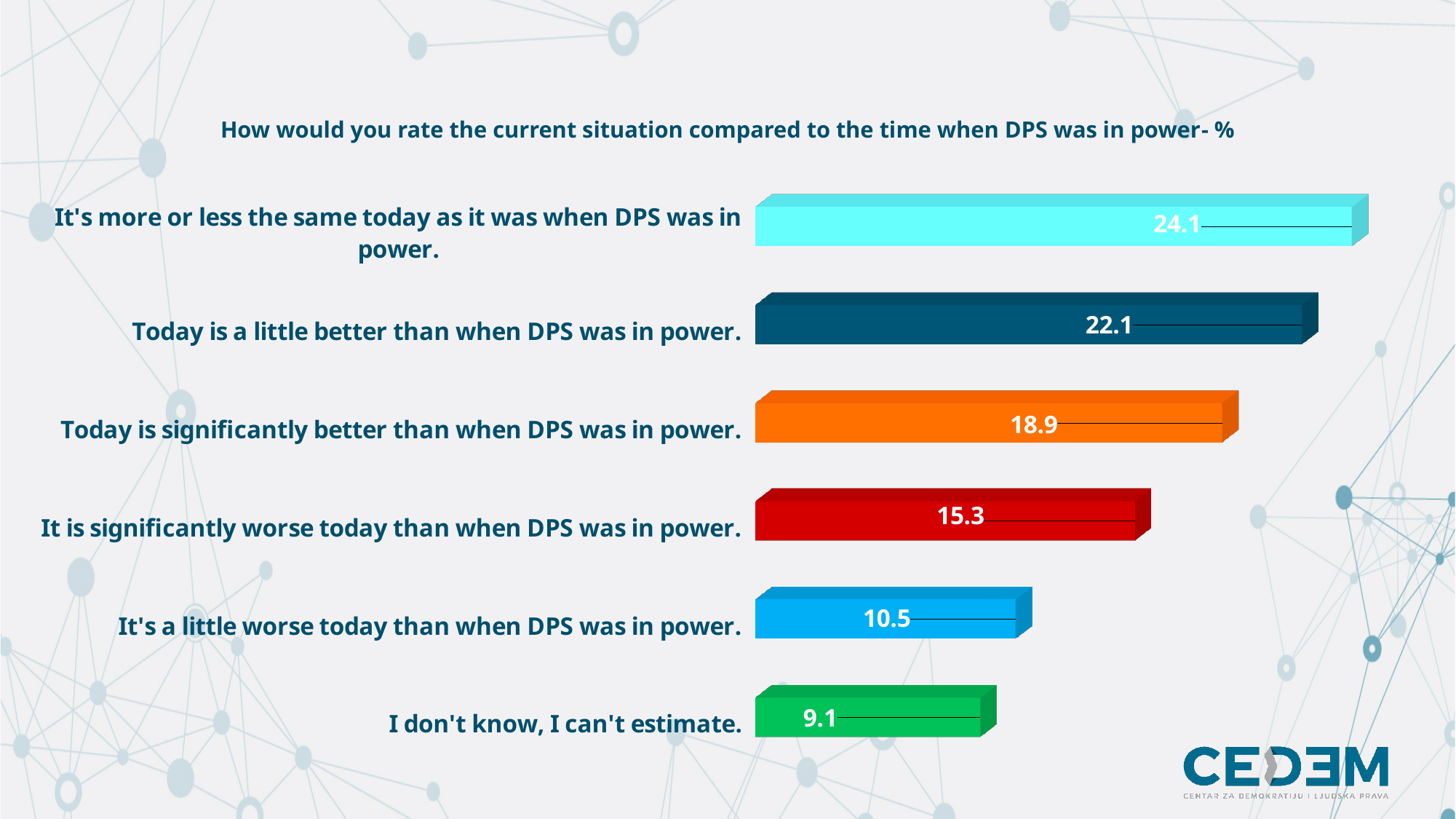
What is the title of the chart? How would you rate the current situation compared to the time when DPS was in power- % What kind of chart is shown on the slide? Bar chart Which is larger: the value for "It is significantly worse today than when DPS was in power." or "It's a little worse today than when DPS was in power."? It is significantly worse today than when DPS was in power. What is the difference between the values for "Today is significantly better than when DPS was in power." and "It's a little worse today than when DPS was in power."? 8.4 What is the difference between the values for "It's more or less the same today as it was when DPS was in power." and "Today is a little better than when DPS was in power."? 2.0 How many categories are shown in the chart? 6 Which category has the lowest value? I don't know, I can't estimate. What is the value for "Today is a little better than when DPS was in power."? 22.1 Which category has the highest value? It's more or less the same today as it was when DPS was in power. What is the value for "I don't know, I can't estimate."? 9.1 What is the value for "It is significantly worse today than when DPS was in power."? 15.3 What colour is the bar for "Today is significantly better than when DPS was in power."? Orange